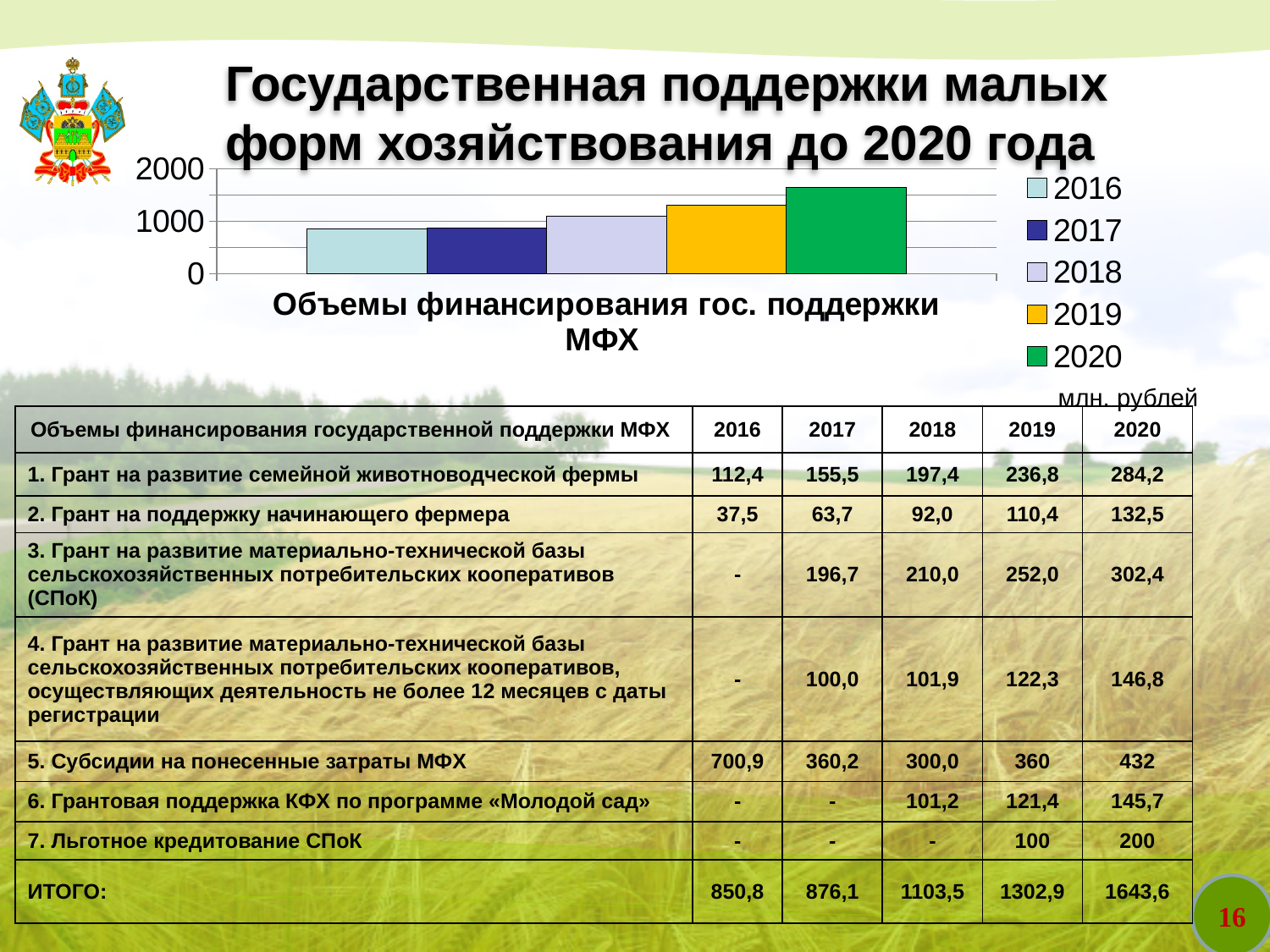
What is the category label shown under the bars of the chart? Объемы финансирования гос. поддержки МФХ Is the value for 2016 in the chart greater or less than 1000? less Is the value for 2020 in the chart greater or less than 2000? less How many categories are shown on the x axis of the chart? 1 What colour is the 2020 series in the chart legend? green Is the value for 2017 in the chart greater or less than 1000? less What kind of chart is shown on the slide? bar chart Which bar is taller in the chart, 2019 or 2018? 2019 Which year has the highest bar in the chart? 2020 How many series does the chart legend list? 5 Do the bar values rise or fall from 2016 to 2020? rise